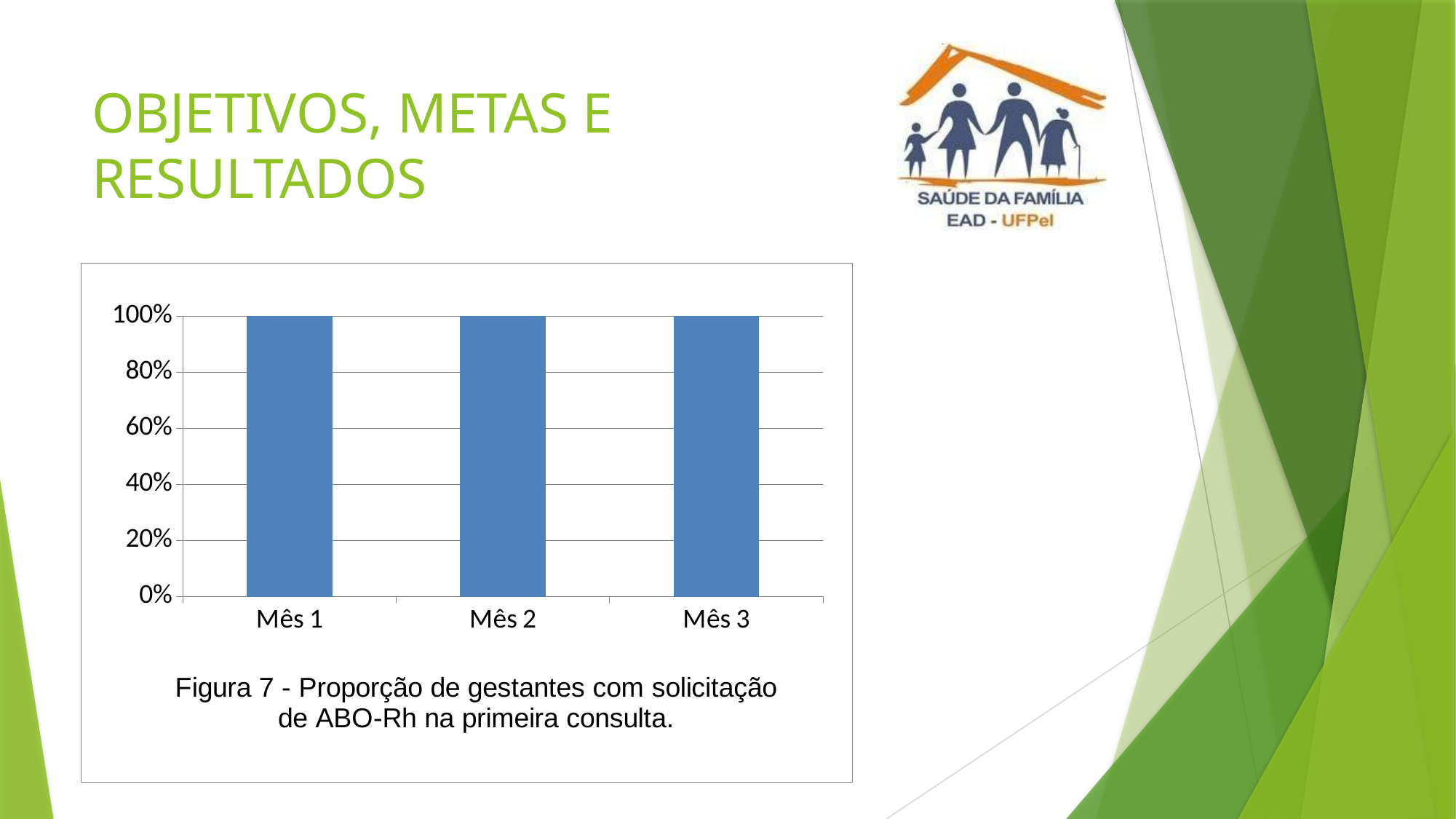
What is the value for Mês 3 in the chart? 100% Is the value for Mês 3 greater or less than 60%? greater What is the highest value shown on the y axis of the chart? 100% What is the figure caption shown below the chart? Figura 7 - Proporção de gestantes com solicitação de ABO-Rh na primeira consulta. Do the values rise, fall, or stay constant from Mês 1 to Mês 3? stay constant What is the value for Mês 1 in the chart? 100% How many categories (months) are plotted on the x axis of the chart? 3 What is the value for Mês 2 in the chart? 100% What is the difference between the values for Mês 1 and Mês 3? 0% Is the value for Mês 2 greater or less than 80%? greater What type of chart is shown on the slide? bar chart